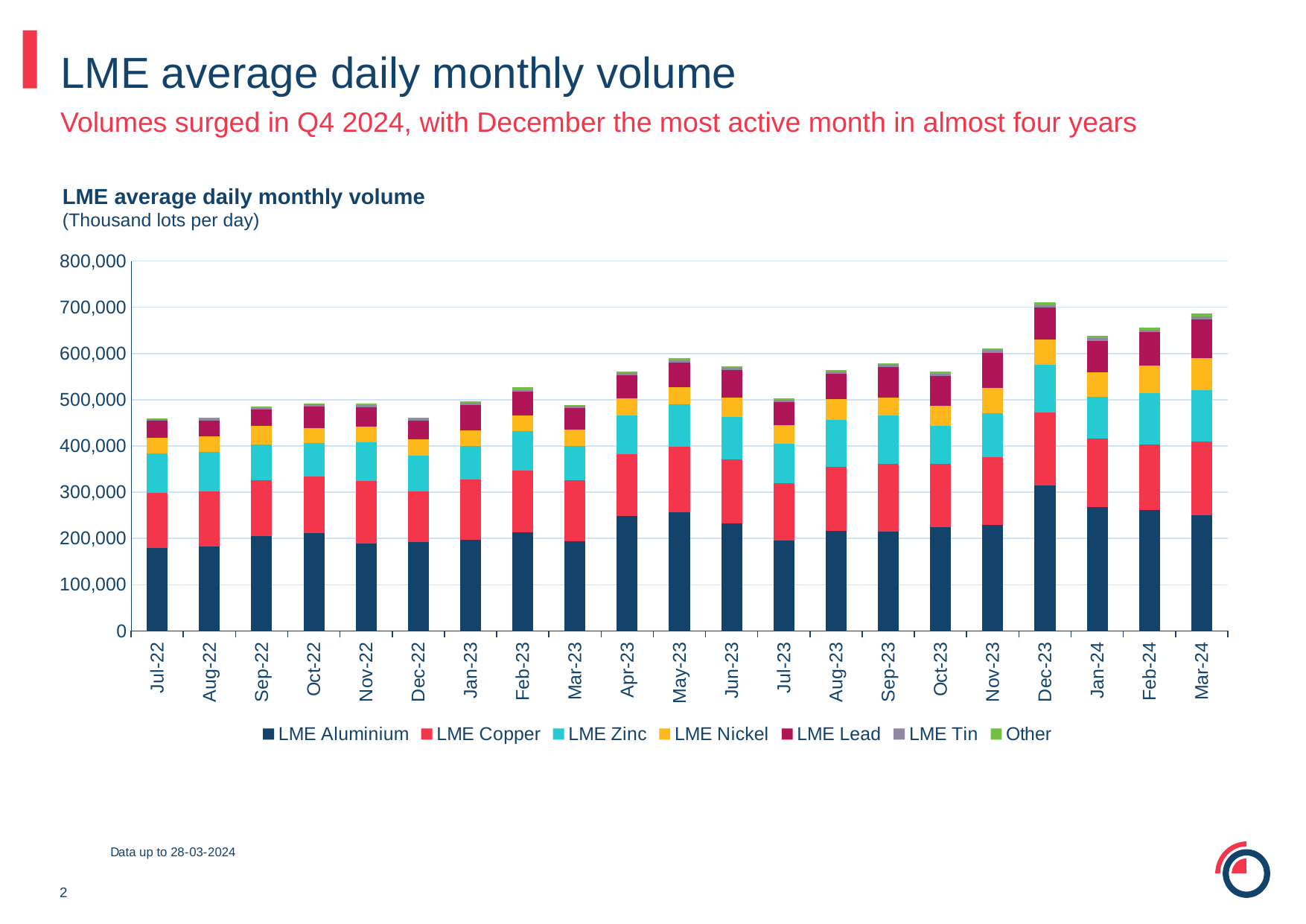
Which month has the larger total volume, Nov-23 or Dec-23? Dec-23 Which month has the highest total average daily volume? Dec-23 Which month has the larger total volume, Mar-23 or Apr-23? Apr-23 Is the total volume for Mar-24 greater or less than 600,000? greater Is the total volume for Jul-22 greater or less than 500,000? less How many series does the legend list? 7 What unit is given under the chart title? Thousand lots per day What kind of chart is shown on the slide? Stacked bar chart Which series is shown at the bottom of each stacked bar? LME Aluminium How many months are shown on the x axis? 21 Is the LME Aluminium value for Jul-22 greater or less than 200,000? less